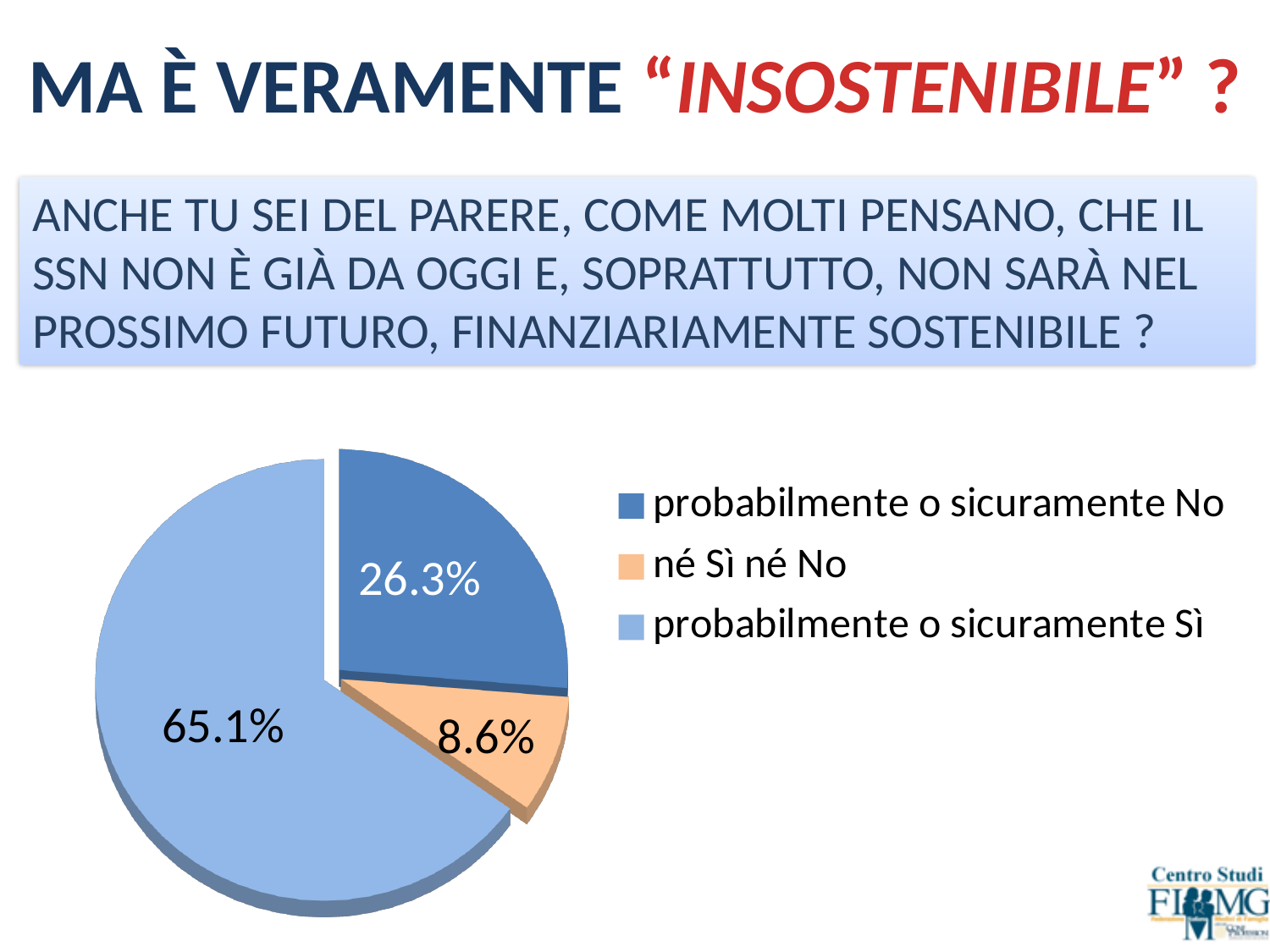
What is the difference between the "probabilmente o sicuramente Sì" slice and the "probabilmente o sicuramente No" slice? 38.8% What colour is the "né Sì né No" slice? orange Which slice of the pie is the smallest? né Sì né No What share of the pie is labelled "probabilmente o sicuramente Sì"? 65.1% Which is larger: the "probabilmente o sicuramente No" slice or the "né Sì né No" slice? probabilmente o sicuramente No What kind of chart is shown on the slide? pie chart What share of the pie is labelled "probabilmente o sicuramente No"? 26.3% Which slice of the pie is the largest? probabilmente o sicuramente Sì How many entries does the legend list? 3 What is the difference between the "probabilmente o sicuramente No" slice and the "né Sì né No" slice? 17.7% How many slices does the pie chart have? 3 What share of the pie is labelled "né Sì né No"? 8.6%